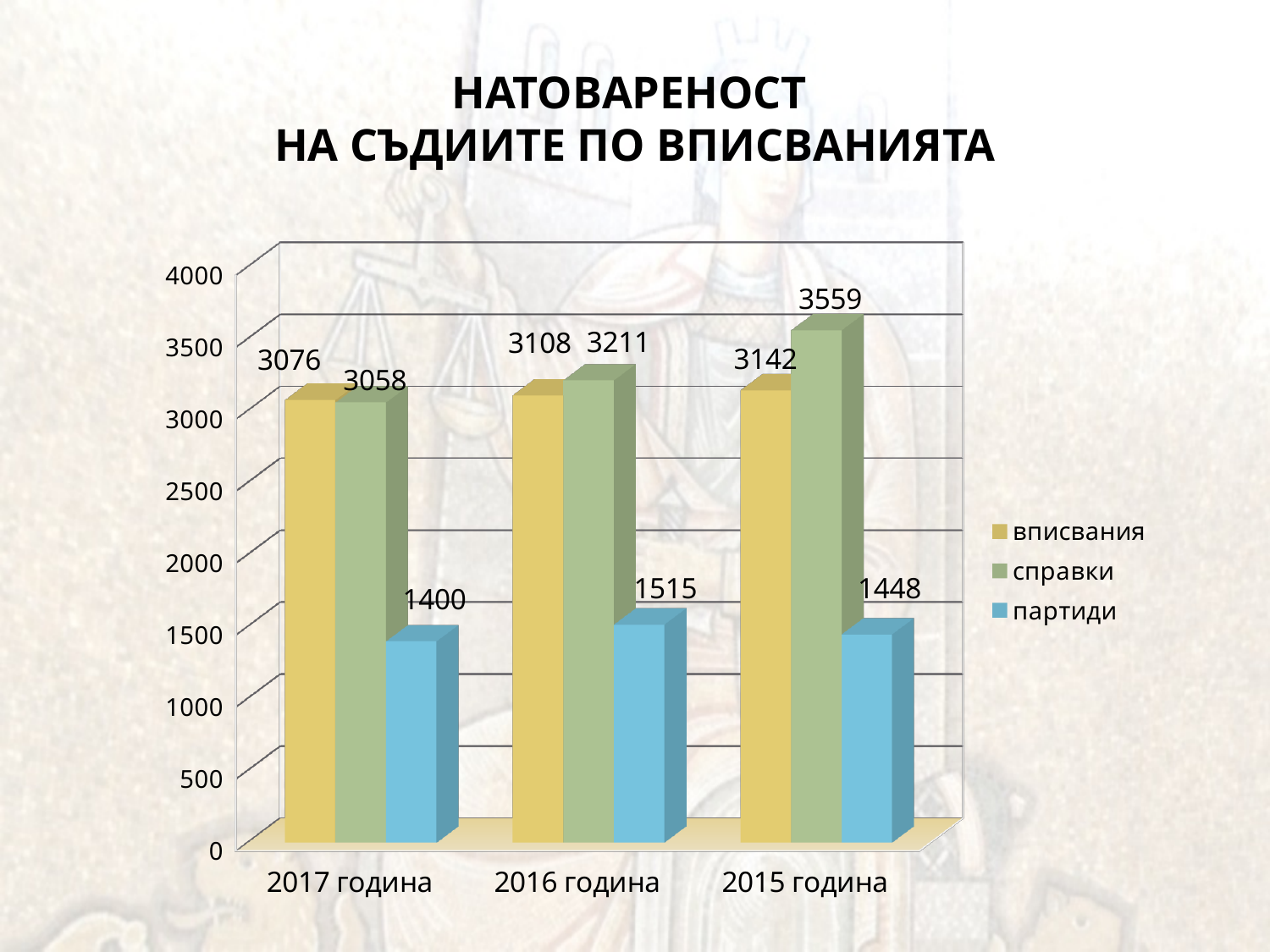
Is the value for партиди in 2015 година greater or less than 1500? less Which is larger in 2017 година: вписвания or справки? вписвания How many year categories are shown on the x axis? 3 Which year has the lowest value for партиди? 2017 година What is the difference between справки and вписвания in 2015 година? 417 What is the value for справки in 2015 година? 3559 What kind of chart is shown on the slide? bar chart How many series does the legend list? 3 What is the value for вписвания in 2017 година? 3076 Which year has the highest value for справки? 2015 година What is the value for партиди in 2016 година? 1515 Which series is shown in blue in the legend? партиди